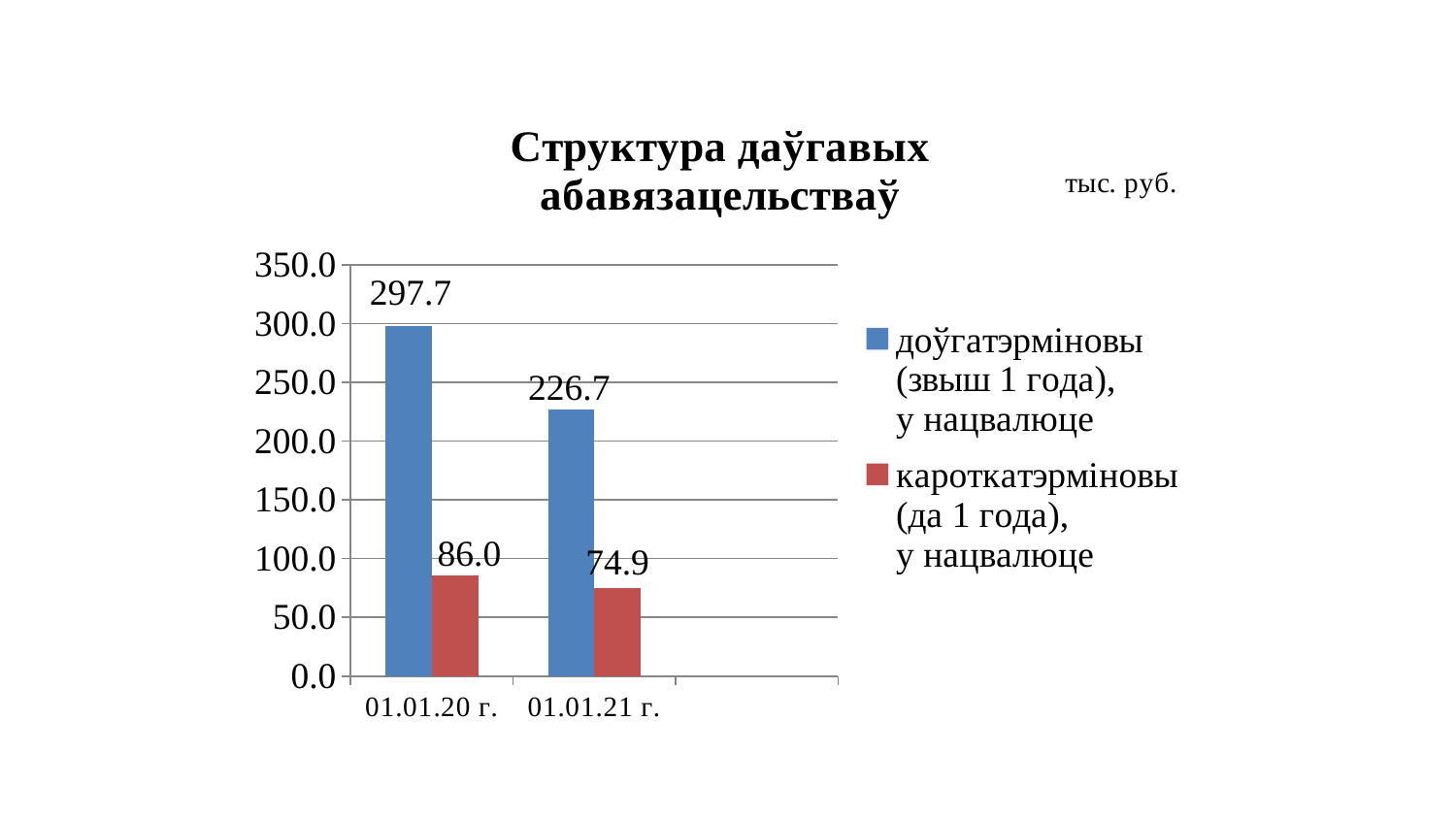
Which bar has the lowest value on the chart? кароткатэрміновы, 01.01.21 г. (74.9) What is the value of the short-term (кароткатэрміновы) series for 01.01.21 г.? 74.9 What is the value of the short-term (кароткатэрміновы) series for 01.01.20 г.? 86.0 Do the long-term (доўгатэрміновы) values rise or fall from 01.01.20 г. to 01.01.21 г.? fall What is the value of the long-term (доўгатэрміновы) series for 01.01.20 г.? 297.7 What is the difference between the short-term values for 01.01.20 г. and 01.01.21 г.? 11.1 How many series does the legend list? 2 Which is larger: the long-term value for 01.01.21 г. or the short-term value for 01.01.20 г.? the long-term value for 01.01.21 г. (226.7) Which bar has the highest value on the chart? доўгатэрміновы, 01.01.20 г. (297.7) What is the value of the long-term (доўгатэрміновы) series for 01.01.21 г.? 226.7 By how much did the long-term (доўгатэрміновы) value decrease from 01.01.20 г. to 01.01.21 г.? 71.0 What kind of chart is shown on the slide? bar chart